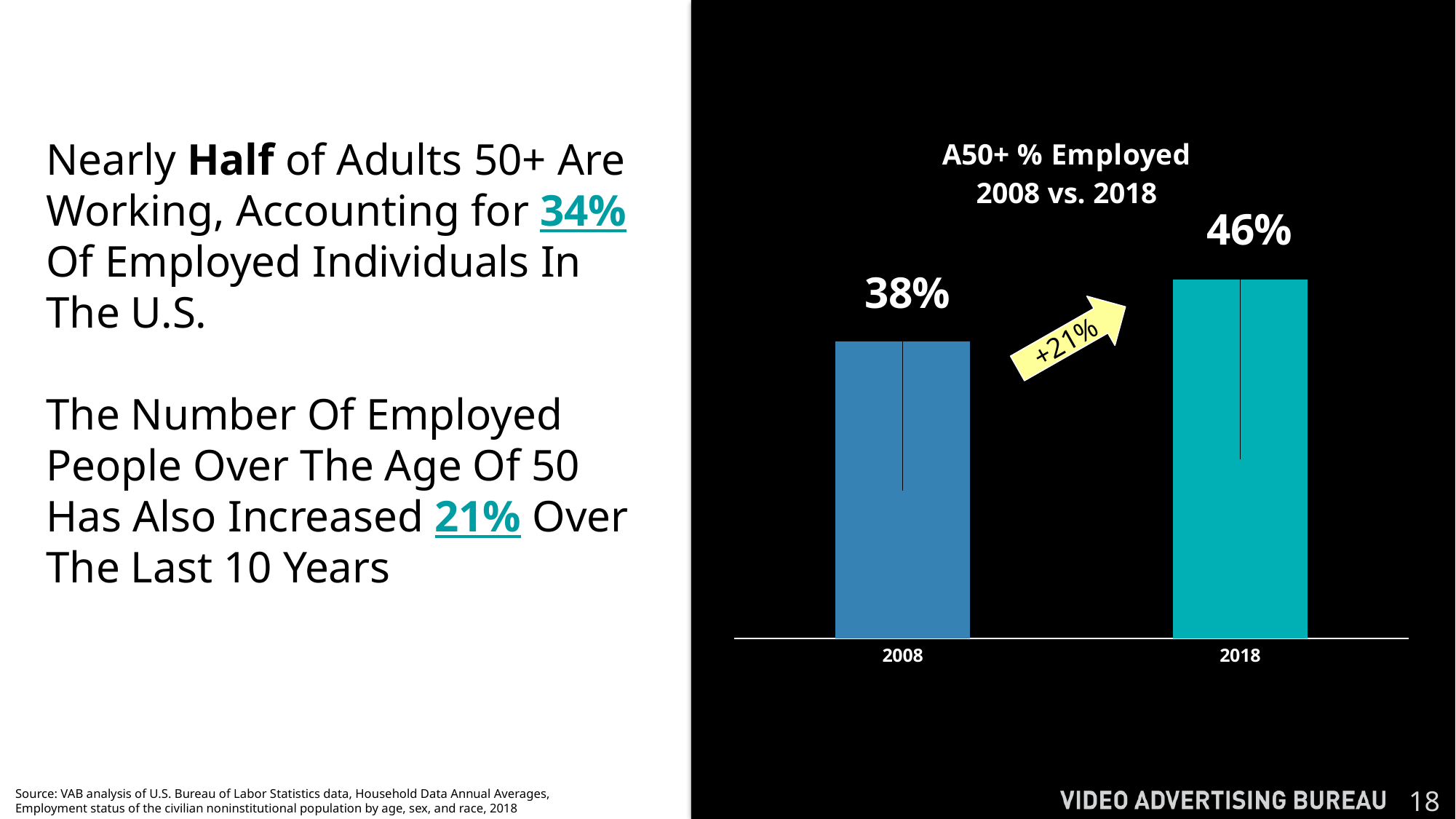
What is the title of the chart? A50+ % Employed 2008 vs. 2018 What is the value for 2008 in the chart? 38% What is the difference in percentage points between the 2018 and 2008 values? 8 Which year has the higher percentage employed? 2018 What kind of chart is shown on the slide? bar chart Which year has the lower percentage employed? 2008 How many bars are shown in the chart? 2 Is the value for 2018 larger or smaller than the value for 2008? larger What percentage change is written on the arrow between the two bars? +21% What is the value for 2018 in the chart? 46% Do the values rise or fall from 2008 to 2018? rise